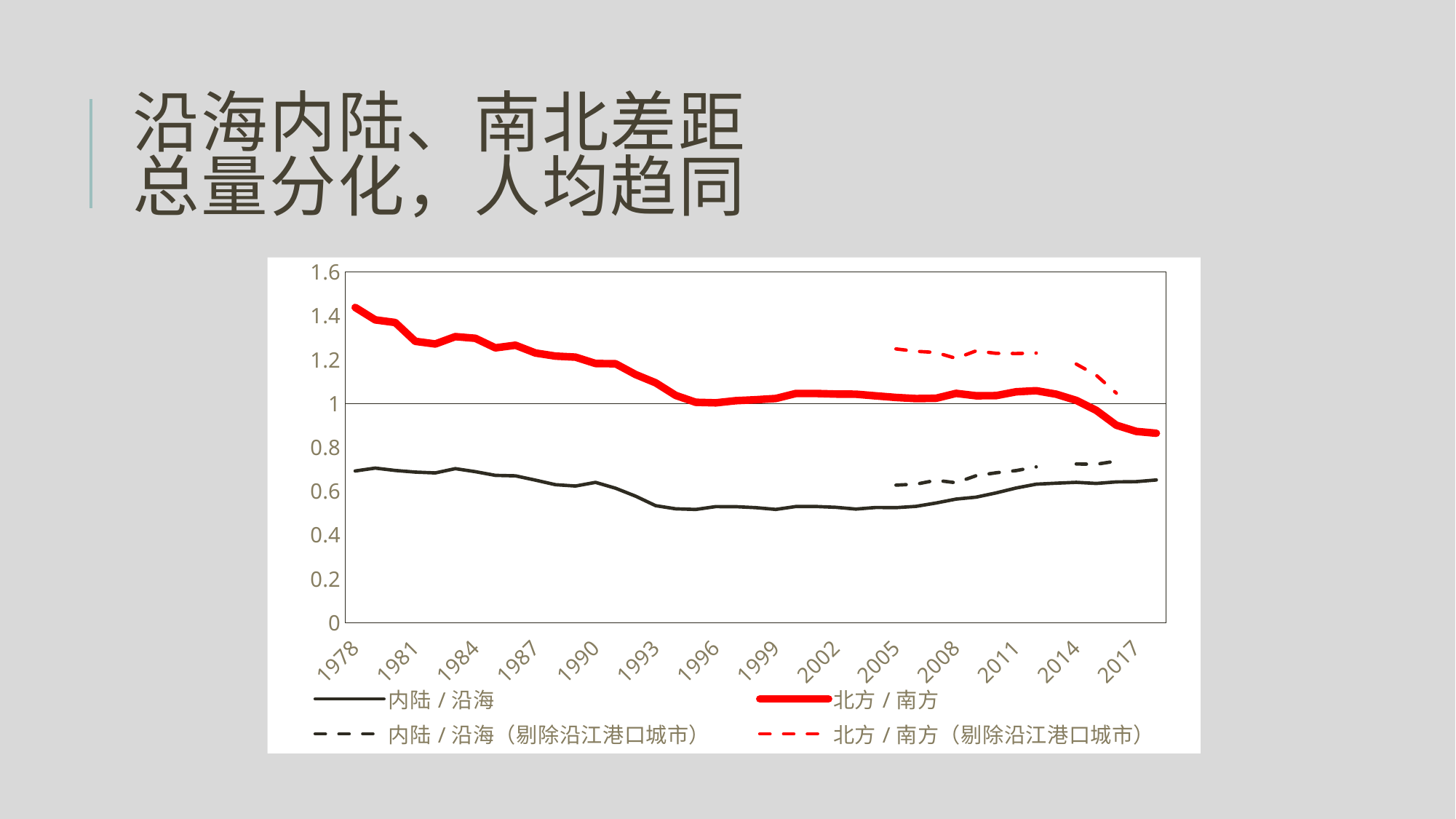
Does the 北方 / 南方 line rise or fall from 1978 to 2017? fall Is the value for 北方 / 南方 in 1978 greater or less than 1.2? greater Is the value for 内陆 / 沿海 in 1978 greater or less than 0.8? less Is the value for 北方 / 南方 in 2017 greater or less than 1? less In 1978, which is larger, 北方 / 南方 or 内陆 / 沿海? 北方 / 南方 In 2017, which is larger, 北方 / 南方 or 内陆 / 沿海? 北方 / 南方 How many series does the legend list? 4 Does the 内陆 / 沿海 line rise or fall from 2005 to 2017? rise What colour is the 北方 / 南方 line? red What kind of chart is shown on the slide? line chart